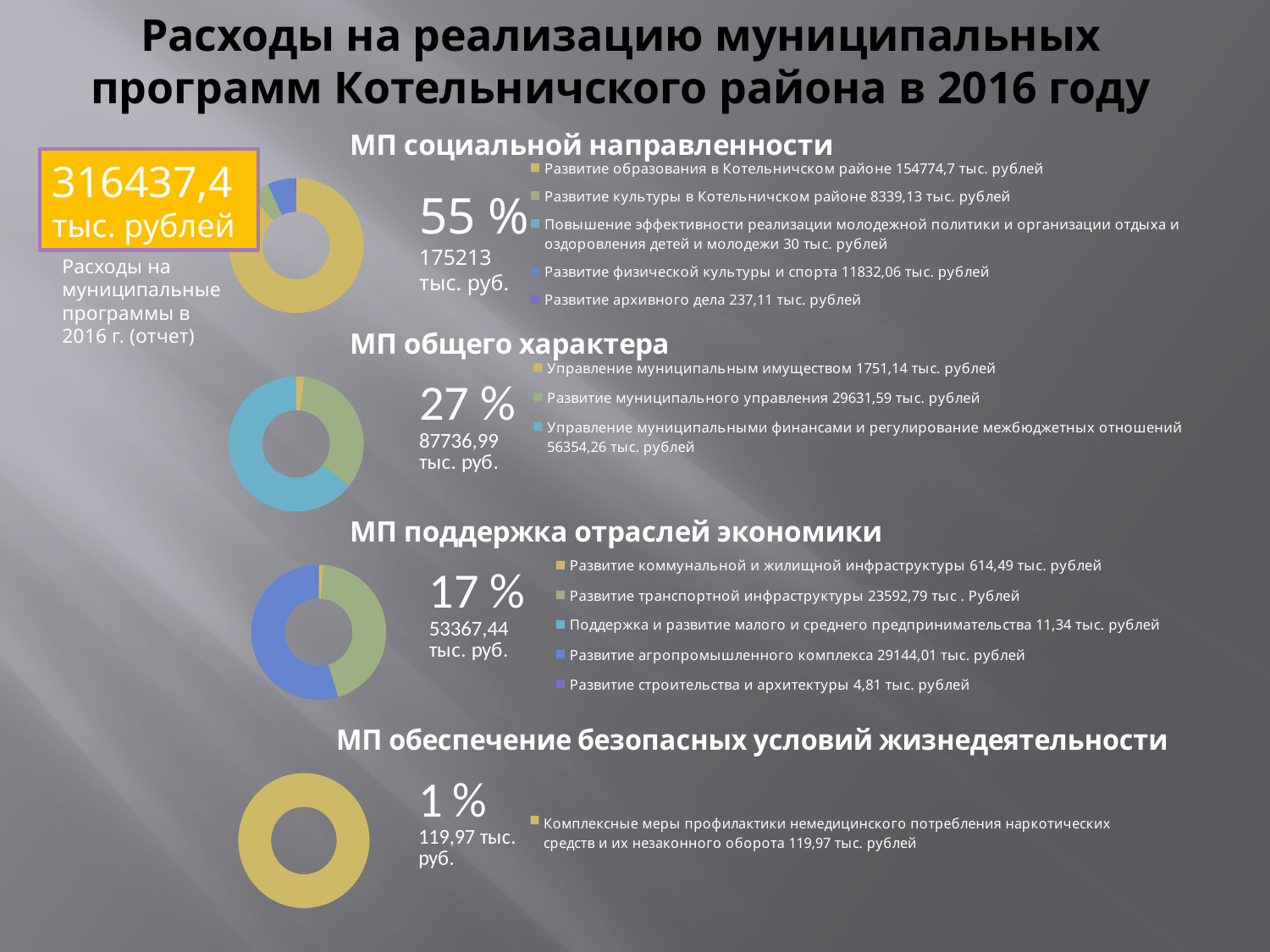
In the chart 'МП социальной направленности', which category has the lowest value? Повышение эффективности реализации молодежной политики и организации отдыха и оздоровления детей и молодежи In the chart 'МП социальной направленности', what is the value for 'Развитие образования в Котельничском районе'? 154774,7 тыс. рублей In the chart 'МП социальной направленности', how many categories does the legend list? 5 In the chart 'МП общего характера', what is the value for 'Управление муниципальными финансами и регулирование межбюджетных отношений'? 56354,26 тыс. рублей In the chart 'МП общего характера', which category has the highest value? Управление муниципальными финансами и регулирование межбюджетных отношений In the chart 'МП обеспечение безопасных условий жизнедеятельности', what is the value for 'Комплексные меры профилактики немедицинского потребления наркотических средств и их незаконного оборота'? 119,97 тыс. рублей In the chart 'МП поддержка отраслей экономики', what is the value for 'Развитие строительства и архитектуры'? 4,81 тыс. рублей In the chart 'МП поддержка отраслей экономики', which is larger: 'Развитие агропромышленного комплекса' or 'Развитие транспортной инфраструктуры'? Развитие агропромышленного комплекса In the chart 'МП общего характера', what is the difference between 'Управление муниципальными финансами и регулирование межбюджетных отношений' and 'Развитие муниципального управления'? 26722,67 тыс. рублей In the chart 'МП поддержка отраслей экономики', what percentage share of total expenditure is shown next to the chart? 17 % In the chart 'МП социальной направленности', what is the difference between 'Развитие физической культуры и спорта' and 'Развитие культуры в Котельничском районе'? 3492,93 тыс. рублей What type of chart is used for 'МП обеспечение безопасных условий жизнедеятельности'? Doughnut chart